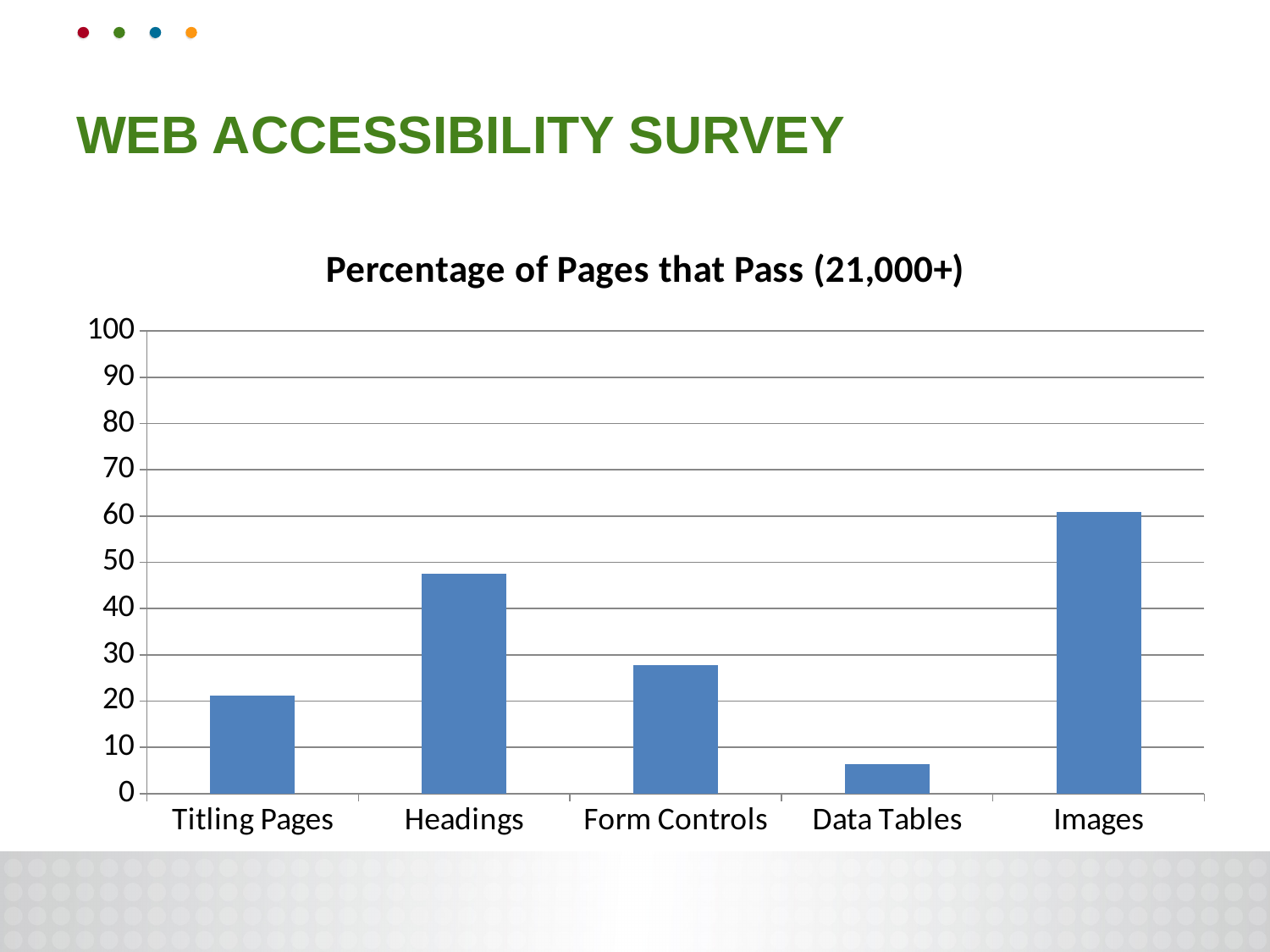
Is the value for Titling Pages greater or less than 30? less How many categories are shown on the x axis of the chart? 5 Is the value for Images greater or less than 50? greater Which is larger, the value for Titling Pages or the value for Data Tables? Titling Pages What kind of chart is shown on the slide? bar chart Is the value for Headings greater or less than 40? greater Which is larger, the value for Headings or the value for Form Controls? Headings What is the title of the chart? Percentage of Pages that Pass (21,000+) Which category has the highest value? Images Which category has the lowest value? Data Tables